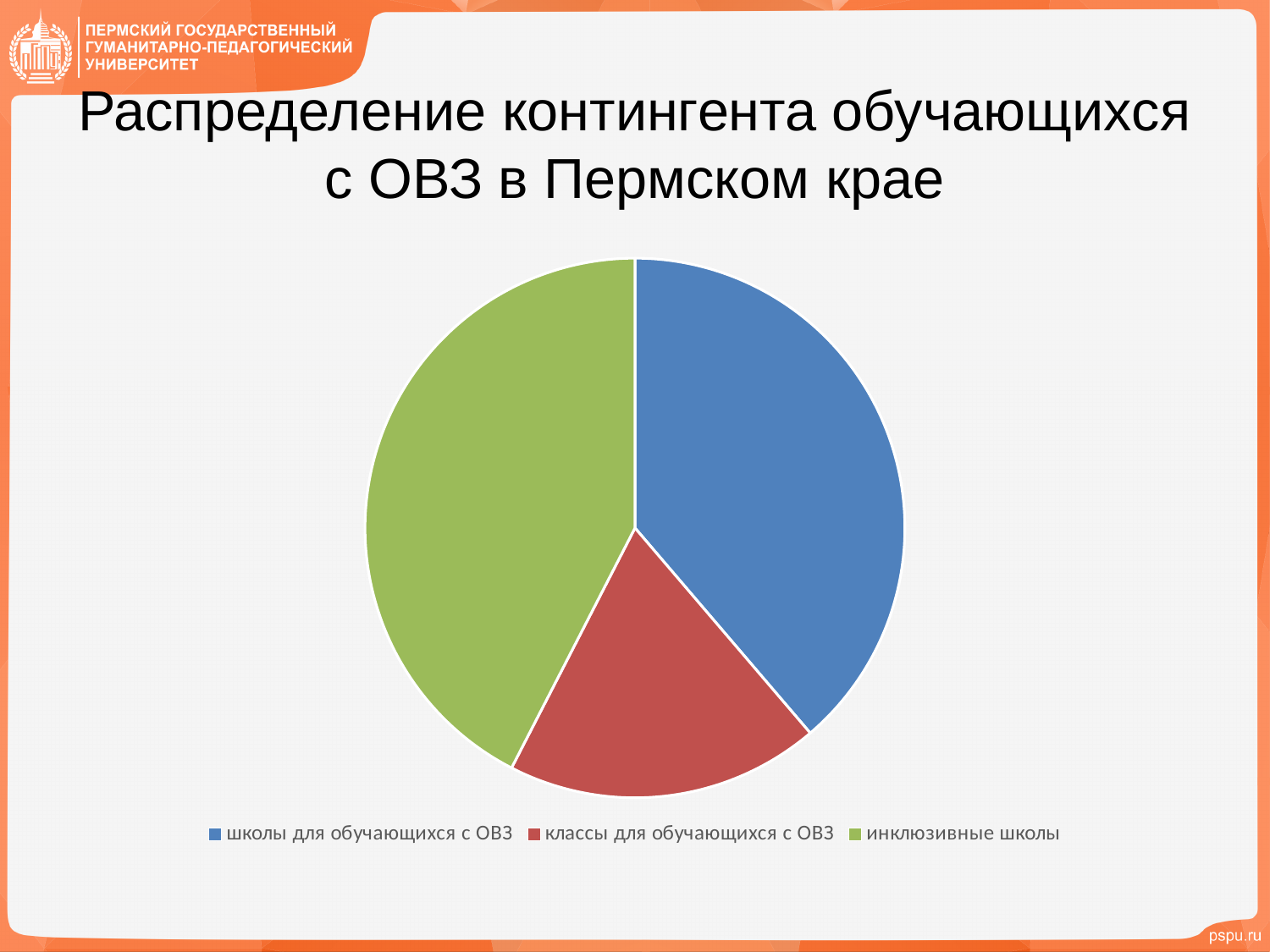
How many slices does the pie chart have? 3 Which slice is larger: школы для обучающихся с ОВЗ or классы для обучающихся с ОВЗ? школы для обучающихся с ОВЗ Which category has the largest slice of the pie chart? инклюзивные школы What kind of chart is shown on the slide? pie chart Which slice is larger: инклюзивные школы or классы для обучающихся с ОВЗ? инклюзивные школы What colour is the slice for инклюзивные школы in the pie chart? green How many entries does the legend of the pie chart list? 3 What is the title of the slide containing the pie chart? Распределение контингента обучающихся с ОВЗ в Пермском крае Which category has the smallest slice of the pie chart? классы для обучающихся с ОВЗ